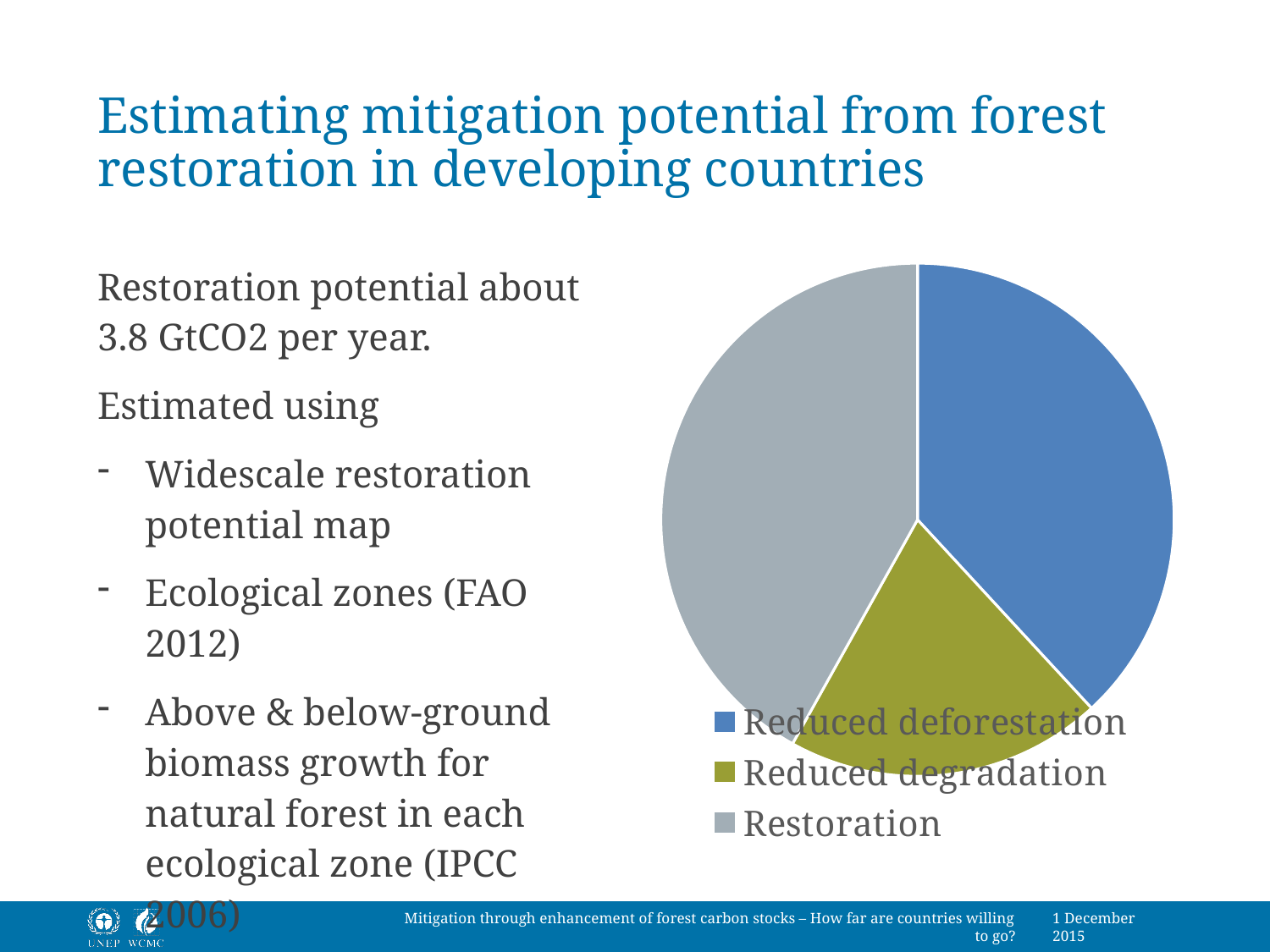
Which category is shown in green in the pie chart? Reduced degradation Which slice is larger in the pie chart: Restoration or Reduced degradation? Restoration What kind of chart is shown on the slide? pie chart Which slice is larger in the pie chart: Reduced deforestation or Reduced degradation? Reduced deforestation How many slices does the pie chart have? 3 Which category has the smallest slice in the pie chart? Reduced degradation What colour is the Restoration slice in the pie chart? grey How many entries does the legend of the pie chart list? 3